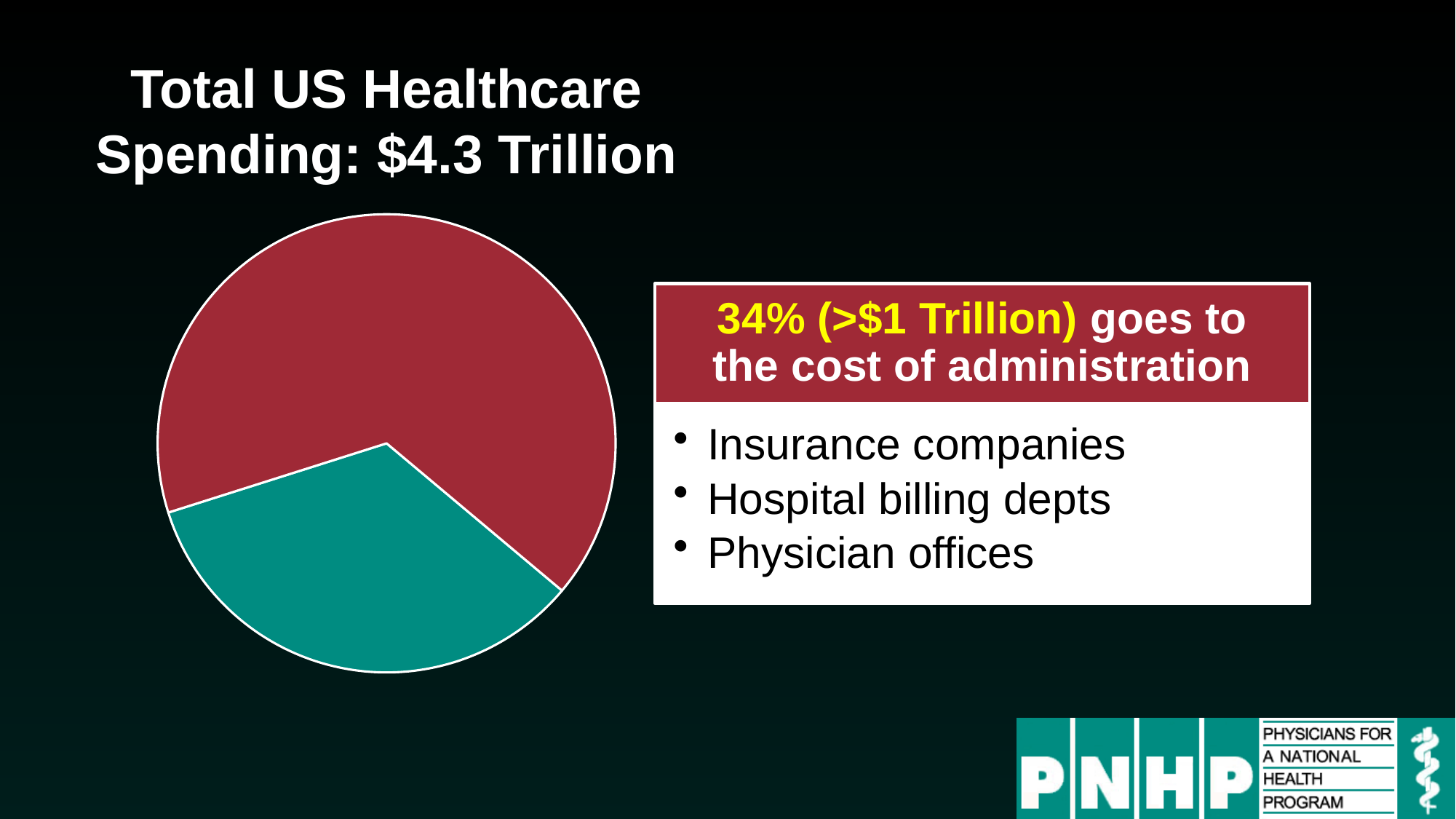
According to the slide, what share of total US healthcare spending goes to the cost of administration? 34% What is the total US healthcare spending stated in the slide title? $4.3 Trillion What colour is the largest slice of the pie chart? red What kind of chart is shown on the slide? pie chart Is the red slice of the pie chart greater or less than 50% of the pie? greater Which slice of the pie chart is larger, the red one or the teal one? the red one How many slices does the pie chart have? 2 How many bulleted examples of administrative cost sources are listed next to the pie chart? 3 What dollar amount does the slide say goes to the cost of administration? >$1 Trillion Is the teal slice of the pie chart greater or less than 50% of the pie? less What colour is the smallest slice of the pie chart? teal